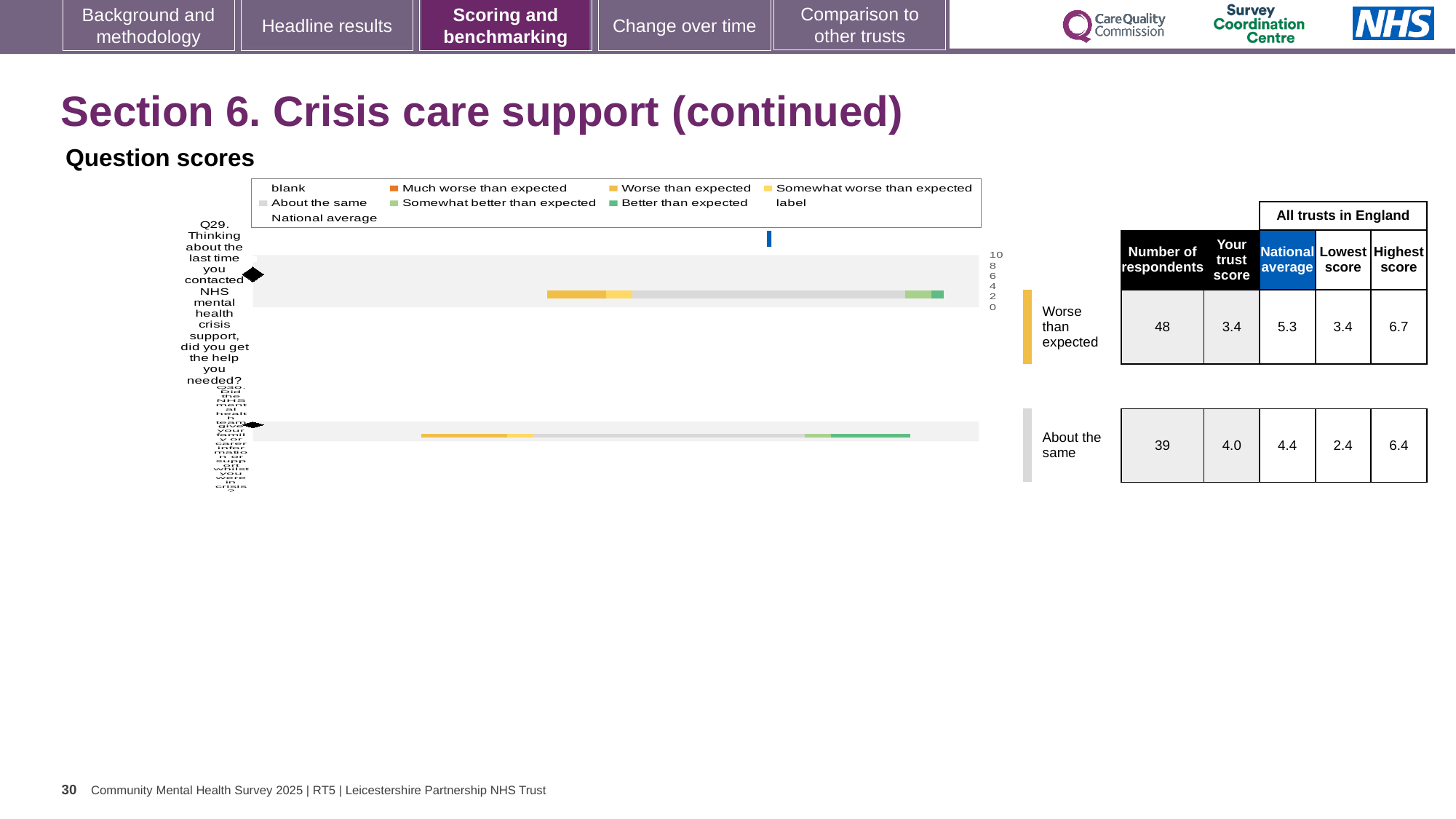
How many entries does the legend of the question scores chart list? 9 What is the national average score for Q29? 5.3 How many questions (bars) are plotted in the question scores chart? 2 What is the trust score for Q29 (did you get the help you needed when you contacted NHS mental health crisis support)? 3.4 How many respondents answered Q29? 48 Which question has the higher trust score, Q29 or Q30? Q30 What is the difference between the highest score and the lowest score for Q29? 3.3 What benchmark category is the trust's score for Q29 placed in? Worse than expected What is the highest score among all trusts in England for Q30? 6.4 How many more respondents answered Q29 than Q30? 9 What kind of chart is used to show the question scores on this slide? bar chart What is the trust score for Q30 (did the NHS mental health team give your family or carer information or support whilst you were in crisis)? 4.0